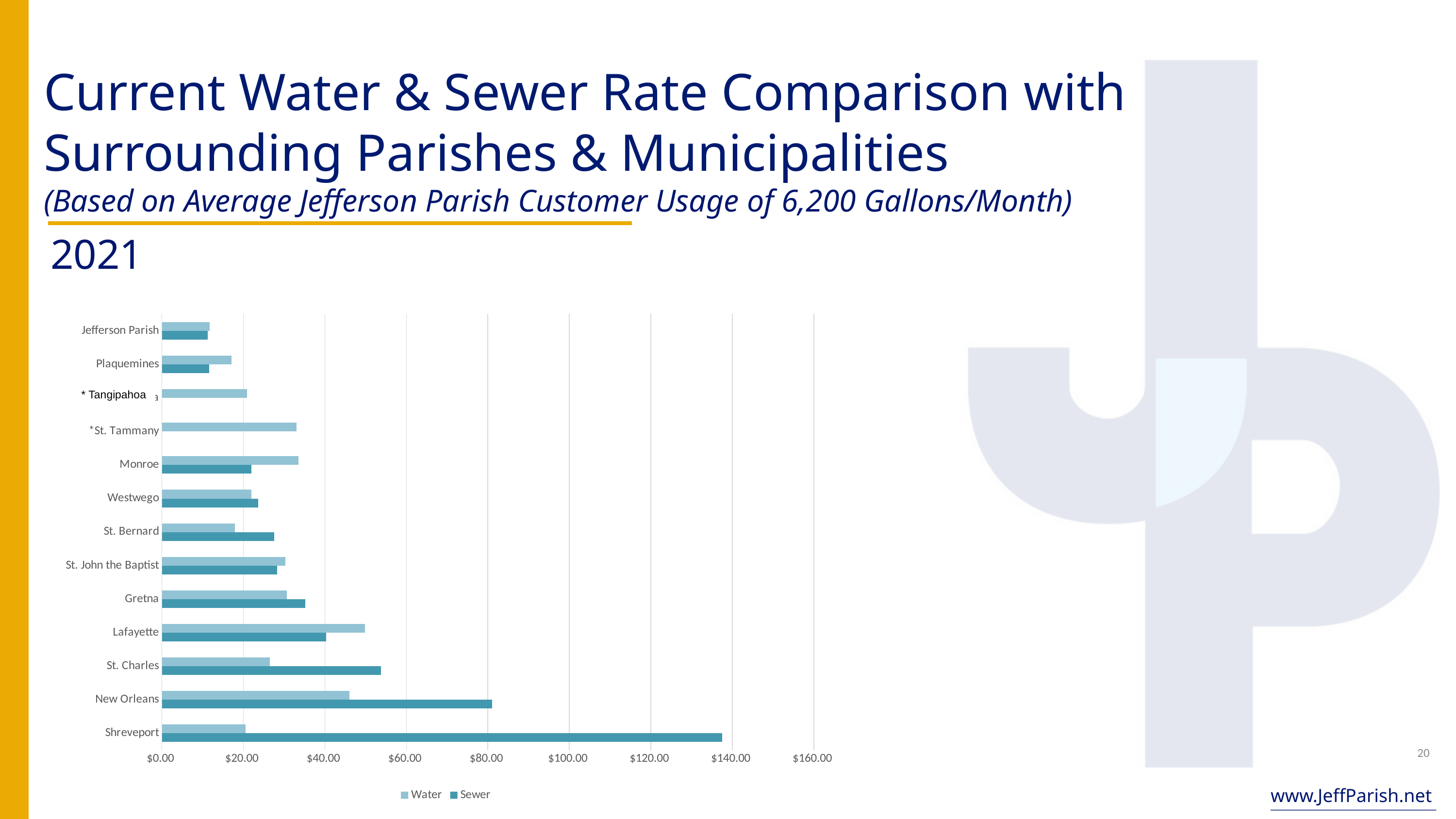
How many series does the chart legend list? 2 Is the Sewer value for St. Charles greater or less than $40.00? greater What are the two series named in the chart legend? Water and Sewer Is the Water value for Lafayette greater or less than $40.00? greater Which parish or municipality has the lowest Water value? Jefferson Parish For New Orleans, which is larger, the Water value or the Sewer value? Sewer For Lafayette, which is larger, the Water value or the Sewer value? Water How many parishes or municipalities are plotted on the chart? 13 Is the Sewer value for Shreveport greater or less than $120.00? greater What kind of chart is shown on the slide? Bar chart Which parish or municipality has the highest Sewer value? Shreveport